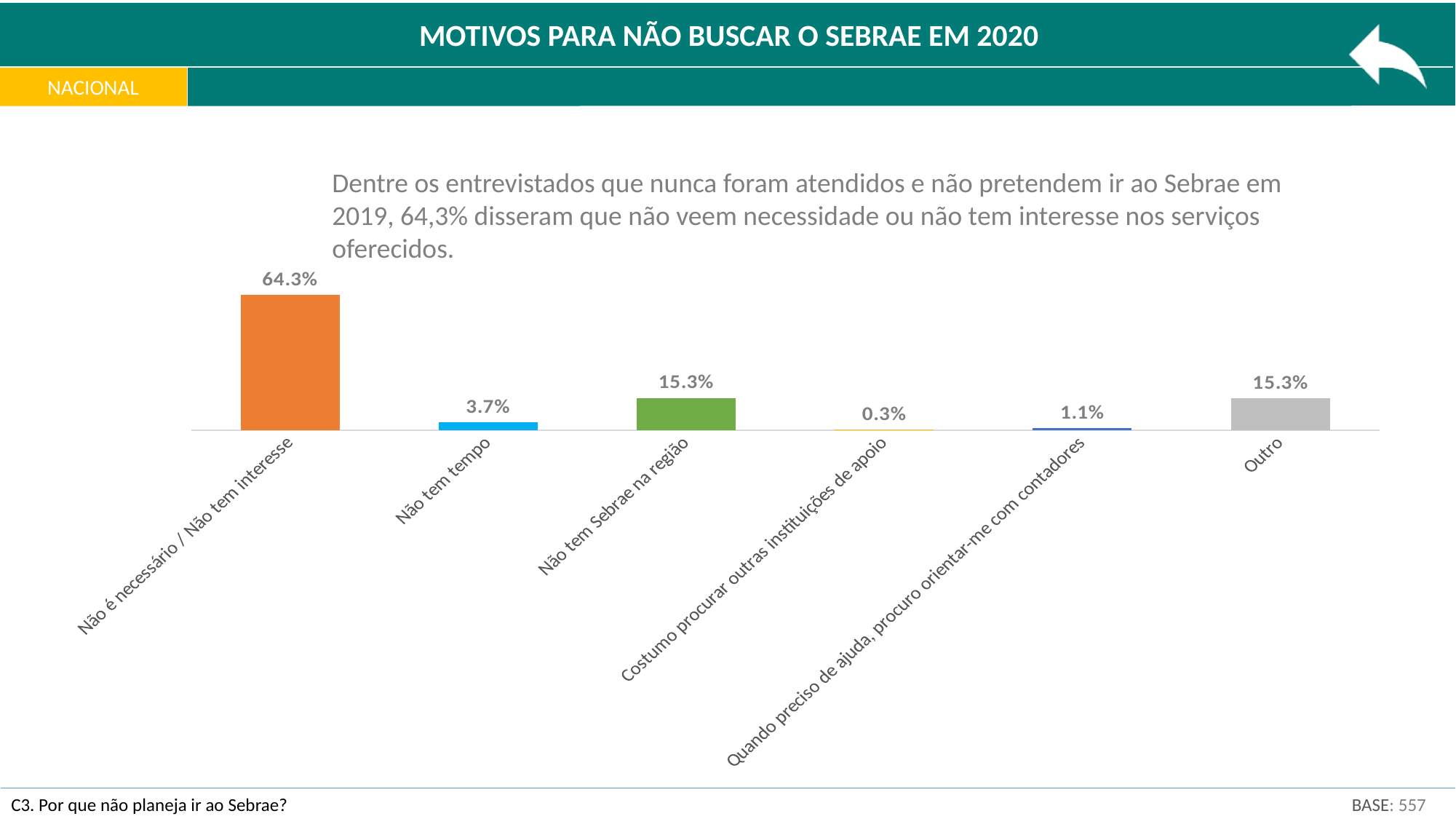
What kind of chart is shown on the slide? Bar chart What is the difference between "Não é necessário / Não tem interesse" and "Não tem Sebrae na região"? 49.0% Which category has the highest value? Não é necessário / Não tem interesse What is the value for "Outro"? 15.3% What is the value for "Não tem tempo"? 3.7% Which is larger, "Não tem tempo" or "Quando preciso de ajuda, procuro orientar-me com contadores"? Não tem tempo What is the value for "Costumo procurar outras instituições de apoio"? 0.3% Which category has the lowest value? Costumo procurar outras instituições de apoio What is the value for "Não é necessário / Não tem interesse"? 64.3% What is the value for "Quando preciso de ajuda, procuro orientar-me com contadores"? 1.1% How many categories are shown in the chart? 6 What is the value for "Não tem Sebrae na região"? 15.3%